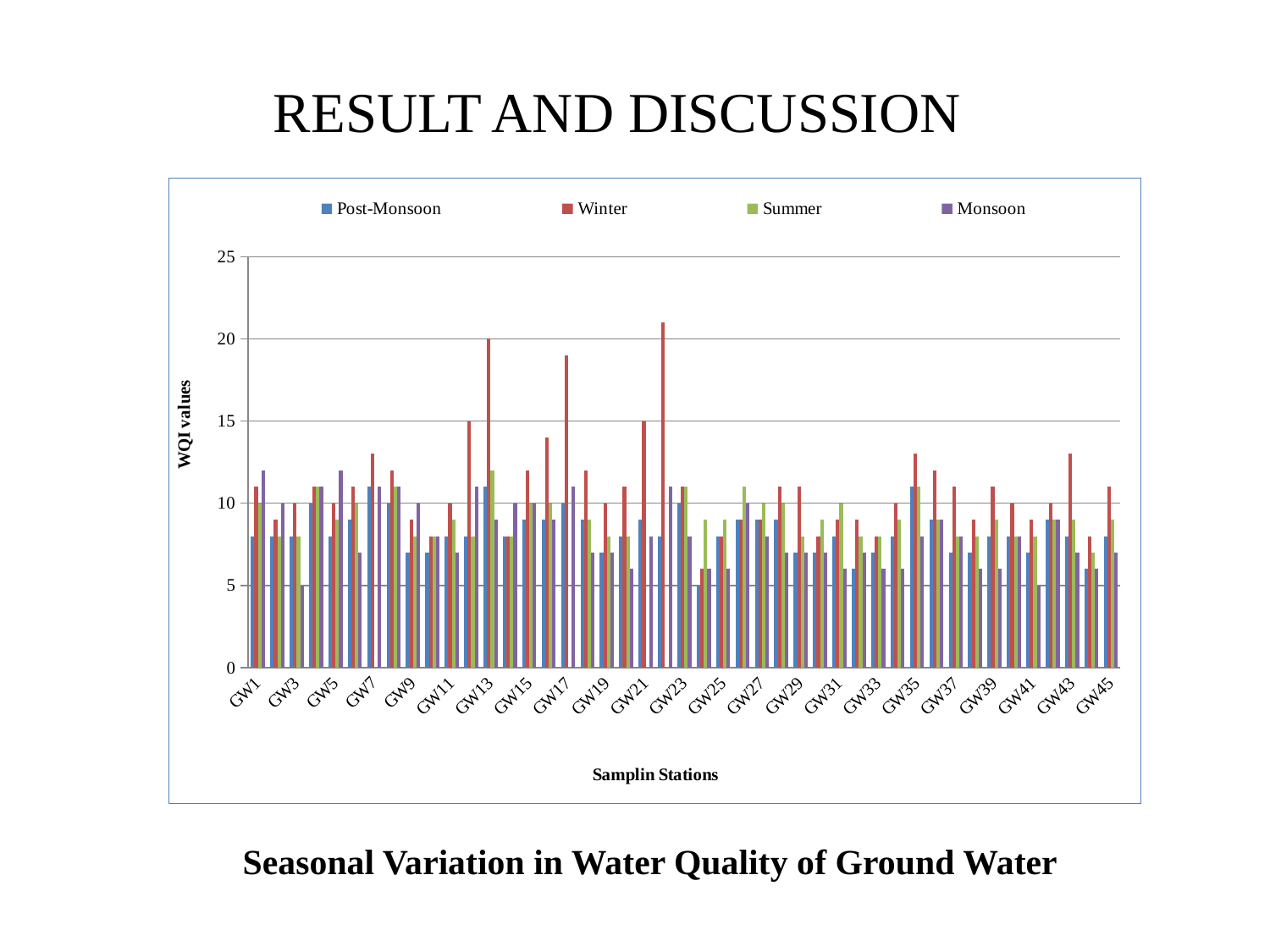
Is the Winter value for GW13 greater or less than 15? greater Is the Monsoon value for GW3 greater or less than 10? less At GW13, which is larger, the Winter value or the Post-Monsoon value? Winter Which series has the tallest bar anywhere in the chart? Winter How many series does the legend list? 4 Is the Winter value for GW7 greater or less than 10? greater What is the label on the vertical axis? WQI values What is the label on the horizontal axis? Samplin Stations What kind of chart is shown on the slide? bar chart How many sampling stations are plotted along the x axis? 45